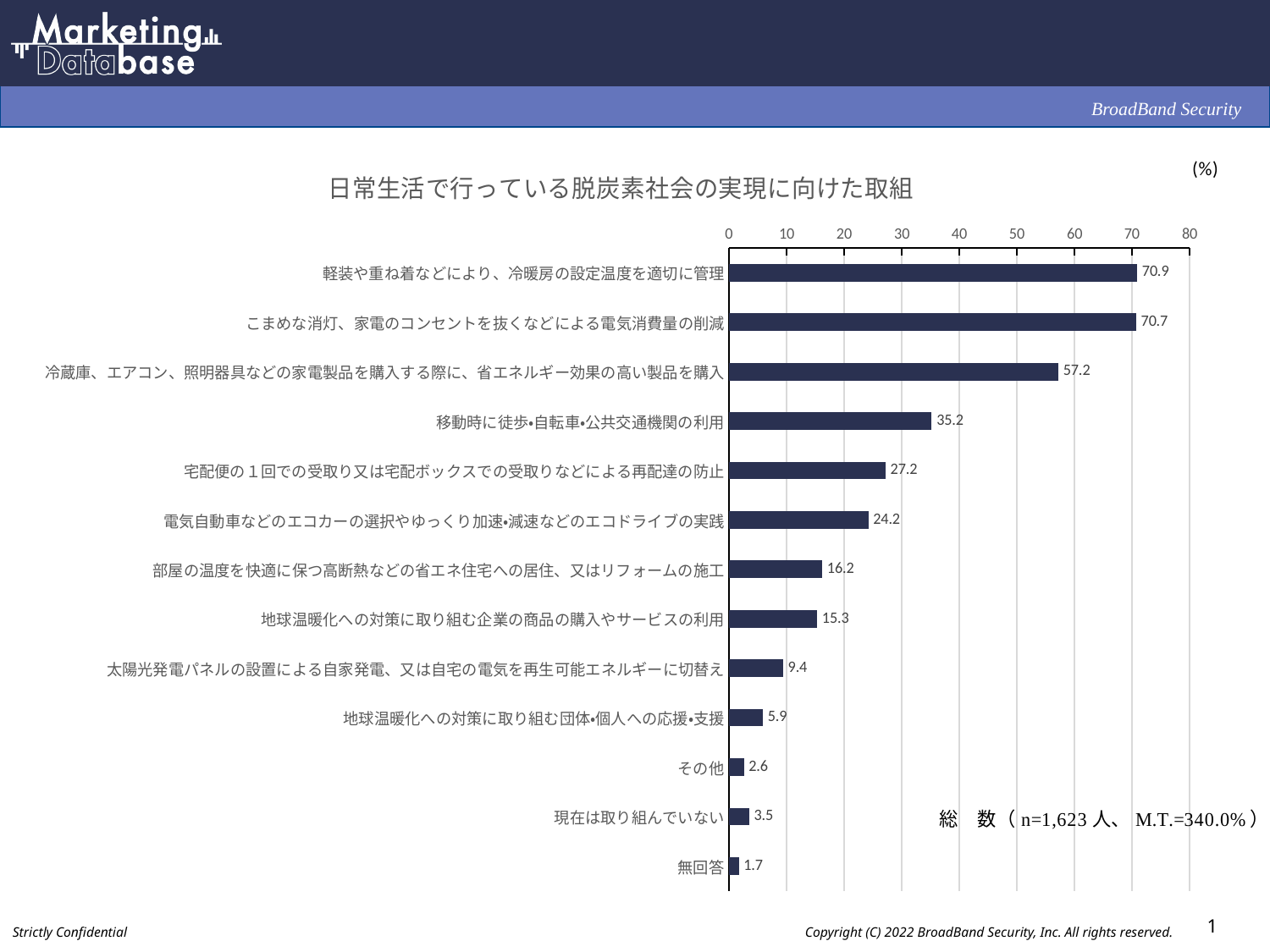
What is the value for 太陽光発電パネルの設置による自家発電、又は自宅の電気を再生可能エネルギーに切替え? 9.4 Is the value for こまめな消灯、家電のコンセントを抜くなどによる電気消費量の削減 greater or less than 60? greater What is the title of the chart? 日常生活で行っている脱炭素社会の実現に向けた取組 What is the value for 宅配便の１回での受取り又は宅配ボックスでの受取りなどによる再配達の防止? 27.2 What kind of chart is shown on the slide? bar chart What is the difference between the values for 部屋の温度を快適に保つ高断熱などの省エネ住宅への居住、又はリフォームの施工 and 地球温暖化への対策に取り組む企業の商品の購入やサービスの利用? 0.9 What is the value for 移動時に徒歩•自転車•公共交通機関の利用? 35.2 What is the value for 現在は取り組んでいない? 3.5 Which is larger: the value for 電気自動車などのエコカーの選択やゆっくり加速•減速などのエコドライブの実践 or the value for 地球温暖化への対策に取り組む団体•個人への応援•支援? 電気自動車などのエコカーの選択やゆっくり加速•減速などのエコドライブの実践 What is the difference between the values for 軽装や重ね着などにより、冷暖房の設定温度を適切に管理 and 冷蔵庫、エアコン、照明器具などの家電製品を購入する際に、省エネルギー効果の高い製品を購入? 13.7 Which category has the lowest value? 無回答 How many categories are shown in the chart? 13